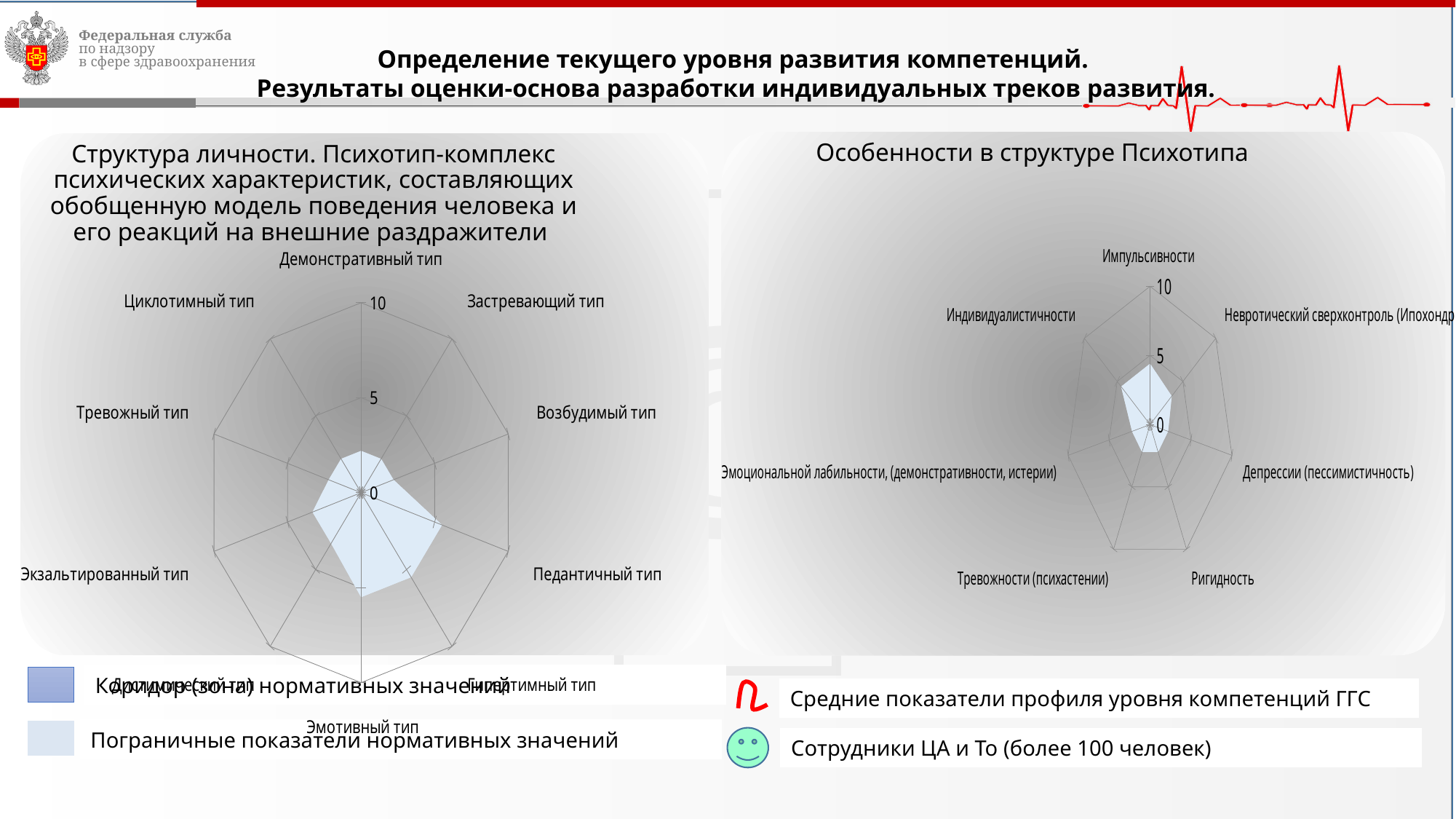
On the left chart "Структура личности", is the value for Демонстративный тип greater or less than 5? less On the left chart "Структура личности", is the value for Экзальтированный тип greater or less than 5? less What kind of chart is the left chart titled "Структура личности"? radar chart On the right chart "Особенности в структуре Психотипа", is the value for Ригидность greater or less than 5? less What is the title of the right chart on the slide? Особенности в структуре Психотипа How many categories (axes) does the right chart "Особенности в структуре Психотипа" have? 7 How many categories (axes) does the left chart "Структура личности" have? 10 What kind of chart is the right chart titled "Особенности в структуре Психотипа"? radar chart What is the maximum value shown on the radial axis of the right chart "Особенности в структуре Психотипа"? 10